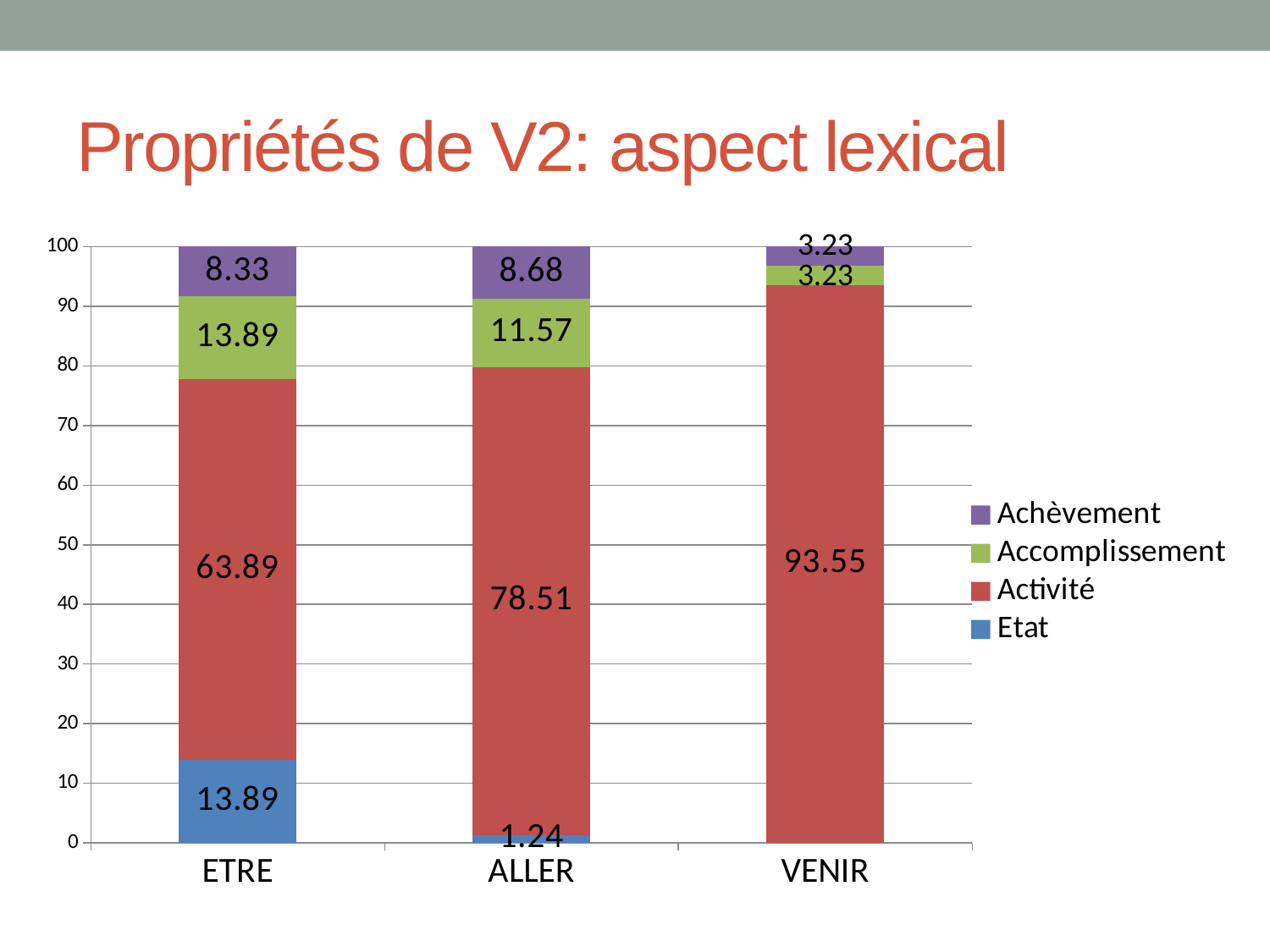
How many categories are shown on the x axis? 3 What is the Accomplissement value for VENIR? 3.23 Which is larger, the Etat value for ETRE or the Etat value for ALLER? ETRE What is the Achèvement value for ALLER? 8.68 What type of chart is shown on the slide? Stacked bar chart Which category has the highest Activité value? VENIR Which category has the lowest Accomplissement value? VENIR What is the Activité value for ETRE? 63.89 What is the difference between the Activité values for ALLER and ETRE? 14.62 What is the Etat value for ALLER? 1.24 What is the Activité value for VENIR? 93.55 How many series does the legend list? 4